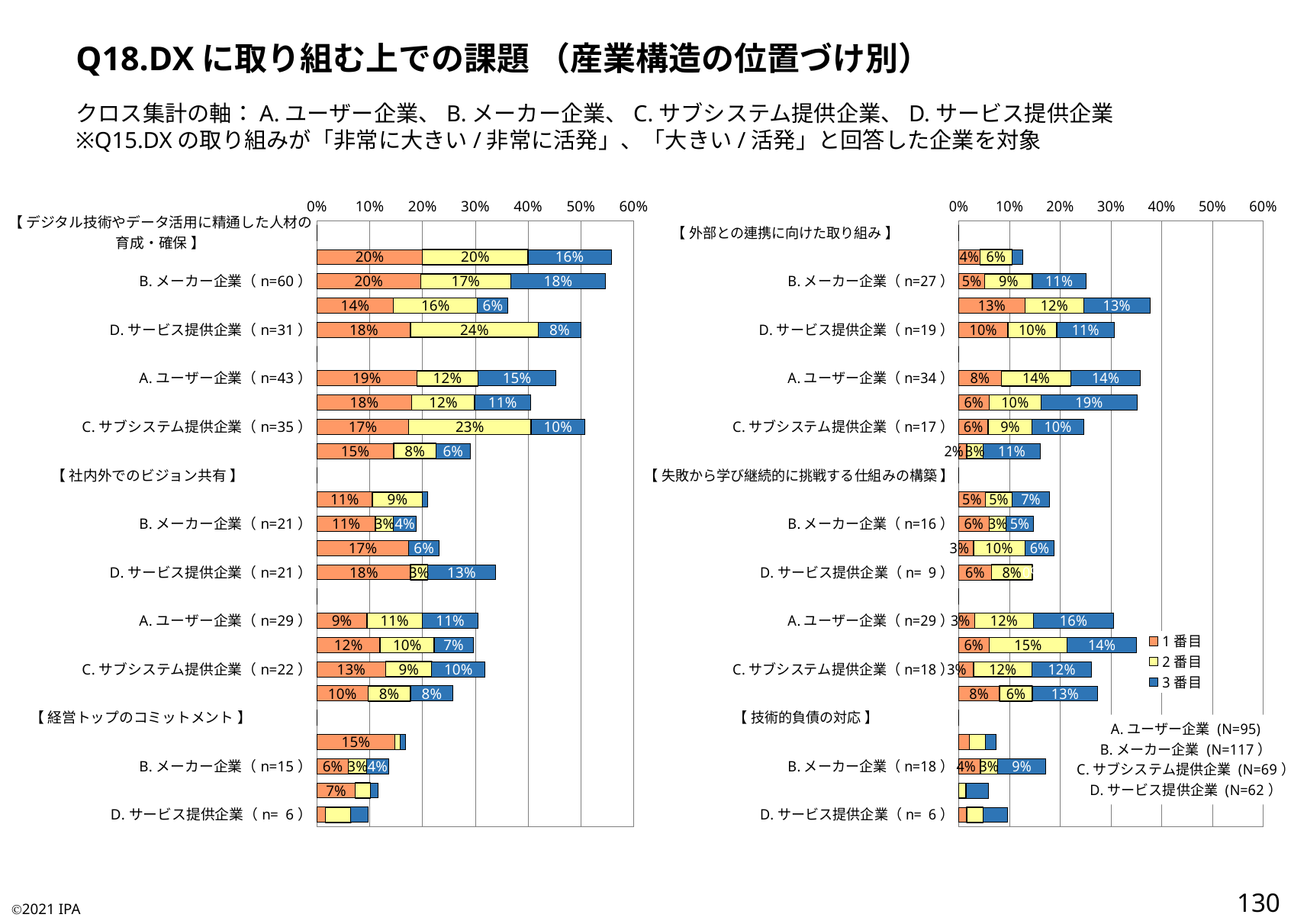
In the right chart, in the 【外部との連携に向けた取り組み】 section, what is the total of the stacked bar for A. ユーザー企業 (n=34)? 36% In the left chart, in the 【デジタル技術やデータ活用に精通した人材の育成・確保】 section, what is the total of the stacked bar for B. メーカー企業 (n=60)? 55% In the left chart, in the 【デジタル技術やデータ活用に精通した人材の育成・確保】 section, how much larger is the 2番目 value for D. サービス提供企業 (n=31) than for B. メーカー企業 (n=60)? 7 percentage points In the right chart, in the 【失敗から学び継続的に挑戦する仕組みの構築】 section, what is the 3番目 value for A. ユーザー企業 (n=29)? 16% In the left chart, in the 【経営トップのコミットメント】 section, what is the total of the stacked bar for B. メーカー企業 (n=15)? 13% What kind of chart is used on this slide? Stacked horizontal bar chart In the left chart, in the 【デジタル技術やデータ活用に精通した人材の育成・確保】 section, what is the 2番目 value for D. サービス提供企業 (n=31)? 24% In the right chart, in the 【外部との連携に向けた取り組み】 section, what is the 3番目 value for D. サービス提供企業 (n=19)? 11% In the left chart, in the 【デジタル技術やデータ活用に精通した人材の育成・確保】 section, what is the 1番目 value for B. メーカー企業 (n=60)? 20% How many series does the legend on the right chart list? 3 In the left chart, in the 【社内外でのビジョン共有】 section, what is the 2番目 value for C. サブシステム提供企業 (n=22)? 9% In the left chart, in the 【デジタル技術やデータ活用に精通した人材の育成・確保】 section, which has the larger 1番目 value: B. メーカー企業 (n=60) or D. サービス提供企業 (n=31)? B. メーカー企業 (n=60)